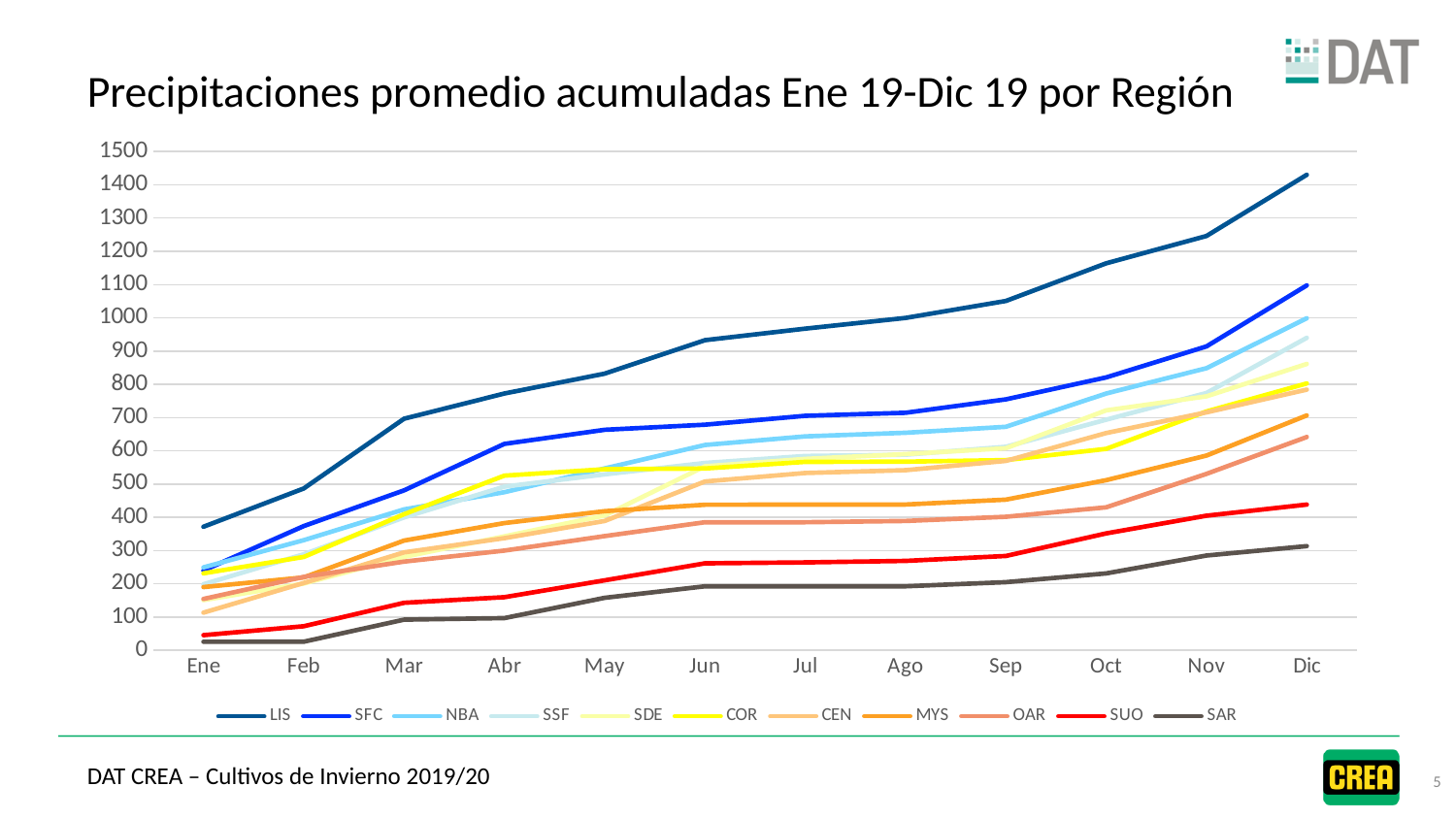
Is the value for SUO in Dic greater or less than 500? less What kind of chart is shown on the slide? line chart Is the value for SAR in Dic greater or less than 400? less Is the value for LIS in Dic greater or less than 1300? greater What is the title of the chart? Precipitaciones promedio acumuladas Ene 19-Dic 19 por Región How many series does the legend list? 11 Do the values for LIS rise or fall from Ene to Dic? rise Which region has the highest accumulated precipitation in Dic? LIS Which region has the lowest accumulated precipitation in Dic? SAR In Jun, which is larger, the value for LIS or the value for SFC? LIS How many months are shown along the x axis? 12